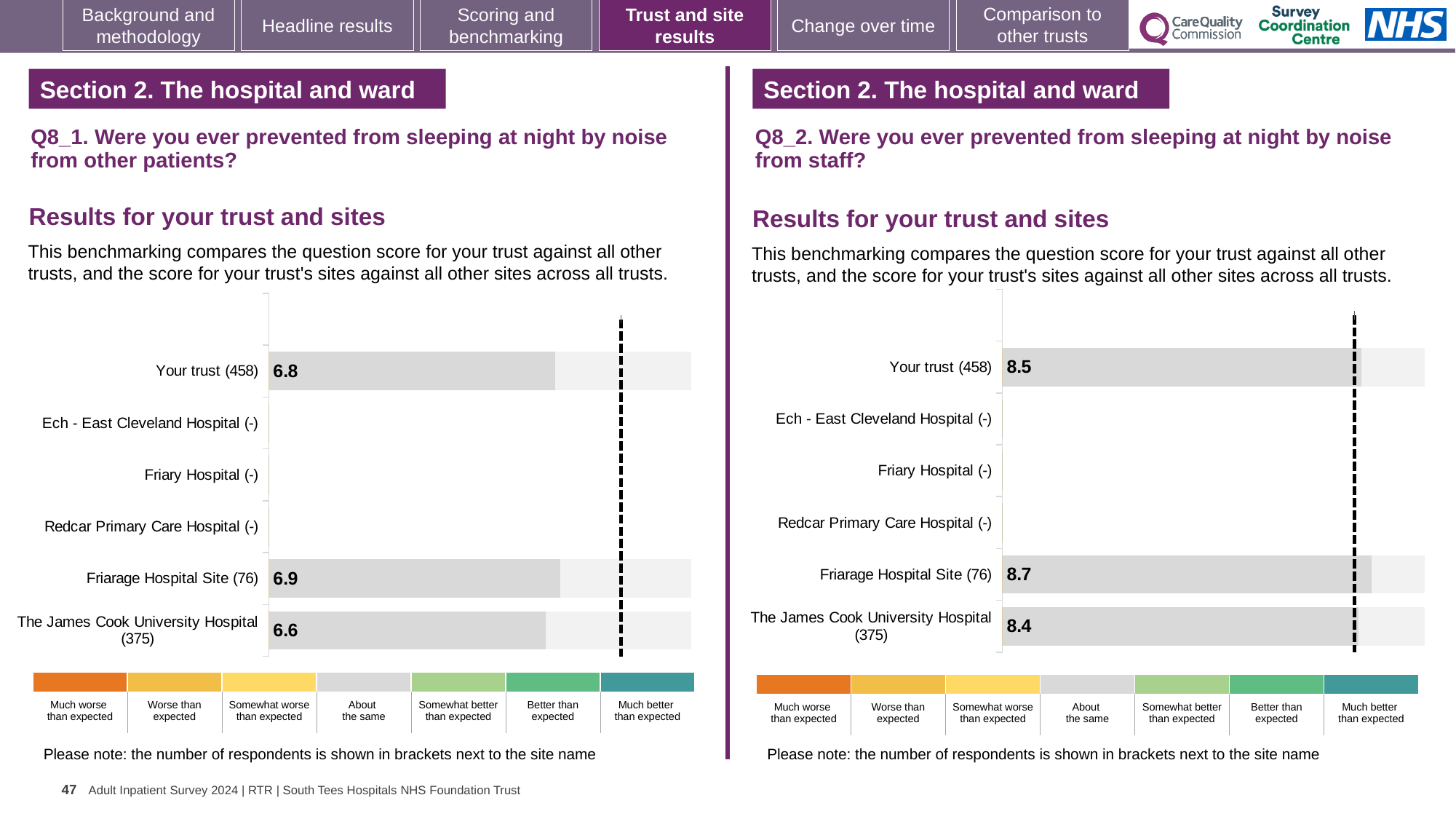
In the Q8_2 chart (noise from staff), what is the difference between the Friarage Hospital Site score and the Your trust score? 0.2 What kind of chart is used in the Q8_2 chart (noise from staff)? Bar chart In the Q8_2 chart (noise from staff), what is the score for Your trust (458)? 8.5 In the Q8_1 chart (noise from other patients), what is the score for Your trust (458)? 6.8 How many site/trust categories are listed on the y axis of the Q8_1 chart (noise from other patients)? 6 In the Q8_1 chart (noise from other patients), which site has the highest score? Friarage Hospital Site (76) In the Q8_1 chart (noise from other patients), what is the difference between the Friarage Hospital Site score and The James Cook University Hospital score? 0.3 In the Q8_2 chart (noise from staff), which is larger: the score for Your trust or the score for The James Cook University Hospital? Your trust In the Q8_2 chart (noise from staff), what is the score for Friarage Hospital Site (76)? 8.7 In the Q8_1 chart (noise from other patients), how many sites show no score (marked with a dash)? 3 In the Q8_1 chart (noise from other patients), what is the score for The James Cook University Hospital (375)? 6.6 In the Q8_2 chart (noise from staff), which site has the lowest score among those with a value shown? The James Cook University Hospital (375)